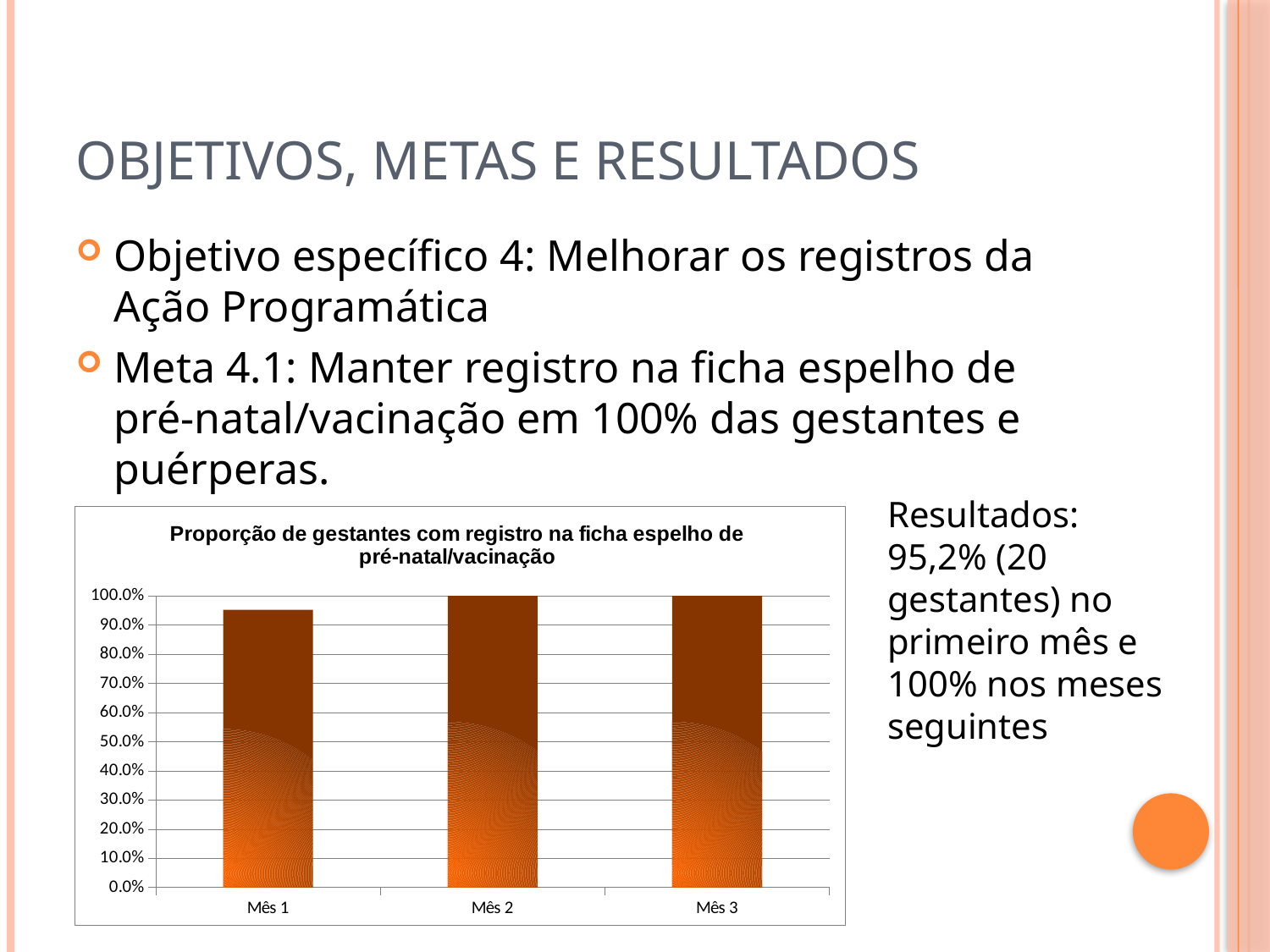
Is the value for Mês 1 greater or less than 100.0%? less What kind of chart is shown on the slide? bar chart Which is larger, the value for Mês 1 or the value for Mês 2? Mês 2 Which month has the lowest value in the chart? Mês 1 What is the highest tick label shown on the y axis of the chart? 100.0% What is the value for Mês 3 in the chart? 100.0% What is the difference between the values for Mês 2 and Mês 3? 0.0% What is the title of the chart? Proporção de gestantes com registro na ficha espelho de pré-natal/vacinação How many months (categories) are plotted on the x axis of the chart? 3 Does the value rise or fall from Mês 1 to Mês 2? rise What is the value for Mês 2 in the chart? 100.0% Is the value for Mês 1 greater or less than 90.0%? greater